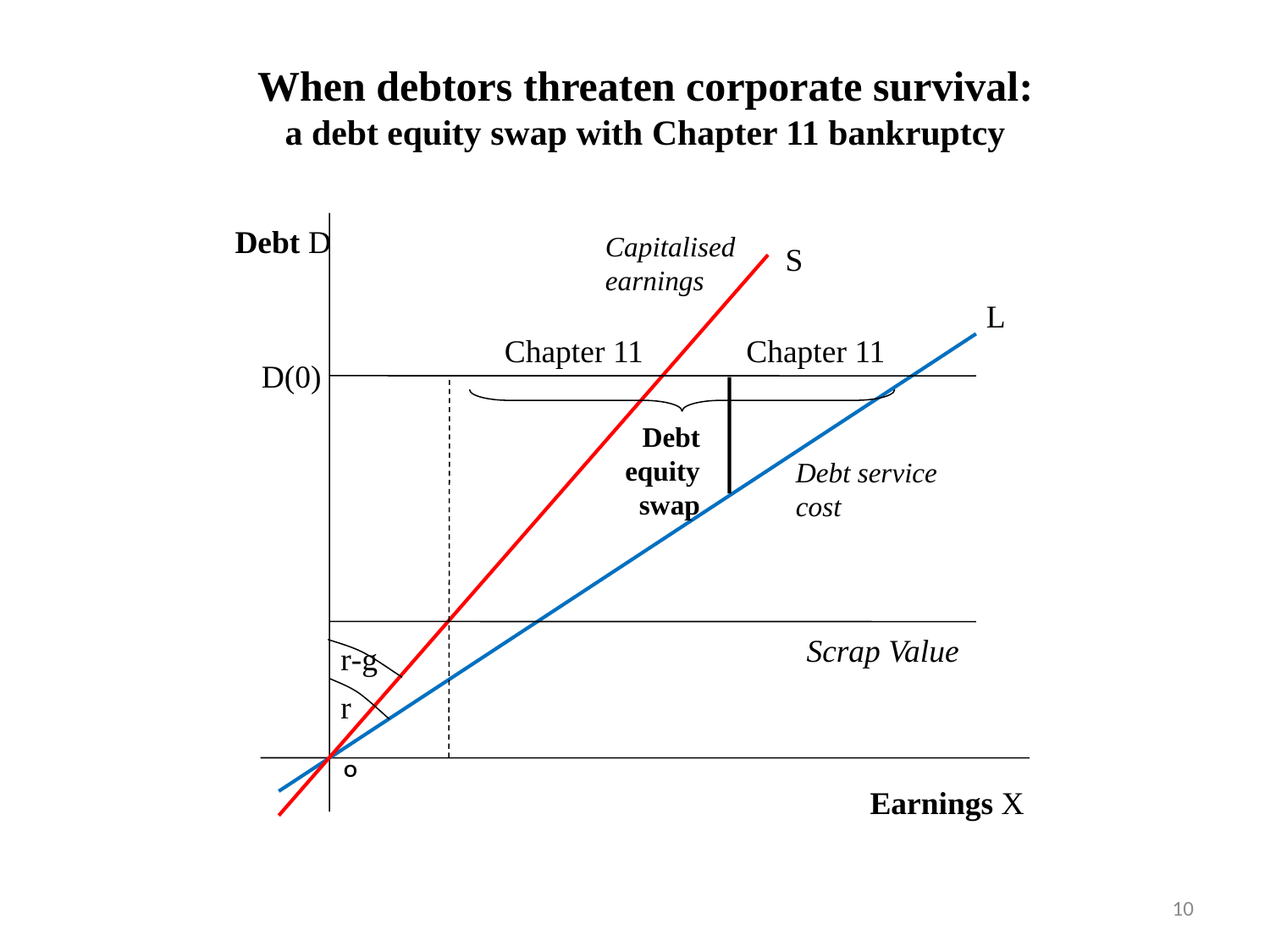
At which labelled point do lines S and L cross? o Which of the two sloped lines, S or L, is steeper? S Which line is labelled "Capitalised earnings"? S What kind of chart is shown on the slide? line chart What is the label of the horizontal axis? Earnings X Does the blue line L rise or fall as Earnings X increases? rise Does the red line S rise or fall as Earnings X increases? rise